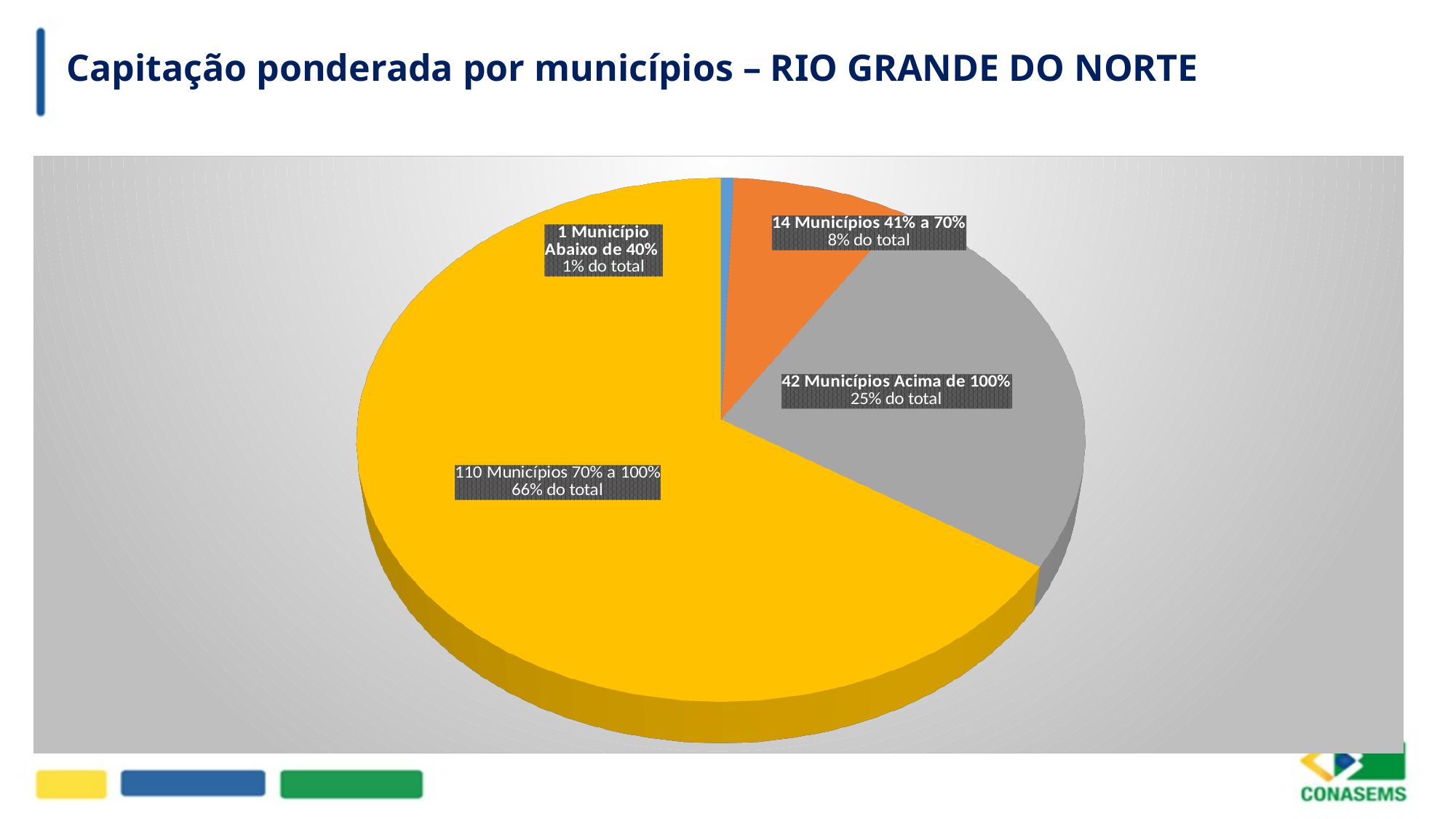
How many municipalities are in the '41% a 70%' category? 14 Which category has the smallest slice of the pie? Abaixo de 40% How many slices does the pie chart have? 4 Which category has more municipalities: '41% a 70%' or 'Acima de 100%'? Acima de 100% How many municipalities are in the 'Acima de 100%' category? 42 What share of the total does the 'Abaixo de 40%' slice represent? 1% What is the difference in the number of municipalities between the '70% a 100%' category and the 'Acima de 100%' category? 68 Which category has the largest slice of the pie? 70% a 100% What share of the total does the 'Acima de 100%' slice represent? 25% How many municipalities are in the '70% a 100%' category? 110 What kind of chart is shown on the slide? Pie chart What is the title of the slide? Capitação ponderada por municípios – RIO GRANDE DO NORTE